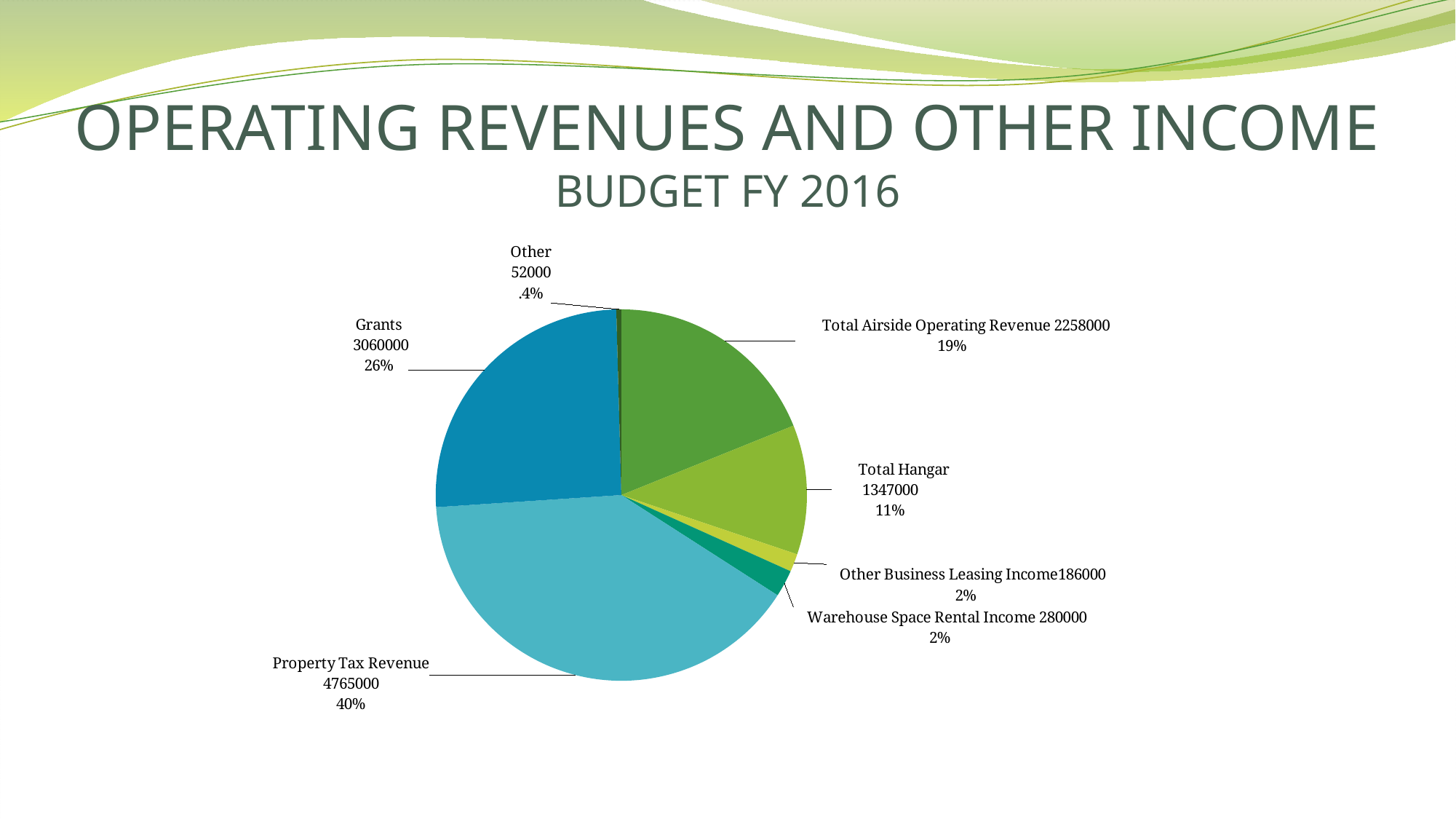
What is the difference between the values for Property Tax Revenue and Grants? 1705000 What is the value for Total Hangar? 1347000 What is the value for Property Tax Revenue? 4765000 What share of the pie does Total Airside Operating Revenue represent? 19% What share of the pie does Other represent? .4% Which category has the smallest slice of the pie? Other Which is larger, the value for Warehouse Space Rental Income or Other Business Leasing Income? Warehouse Space Rental Income Which category has the largest slice of the pie? Property Tax Revenue How many slices does the pie chart have? 7 What type of chart is shown on the slide? Pie chart What is the value for Grants? 3060000 What is the title of the slide containing the chart? OPERATING REVENUES AND OTHER INCOME BUDGET FY 2016